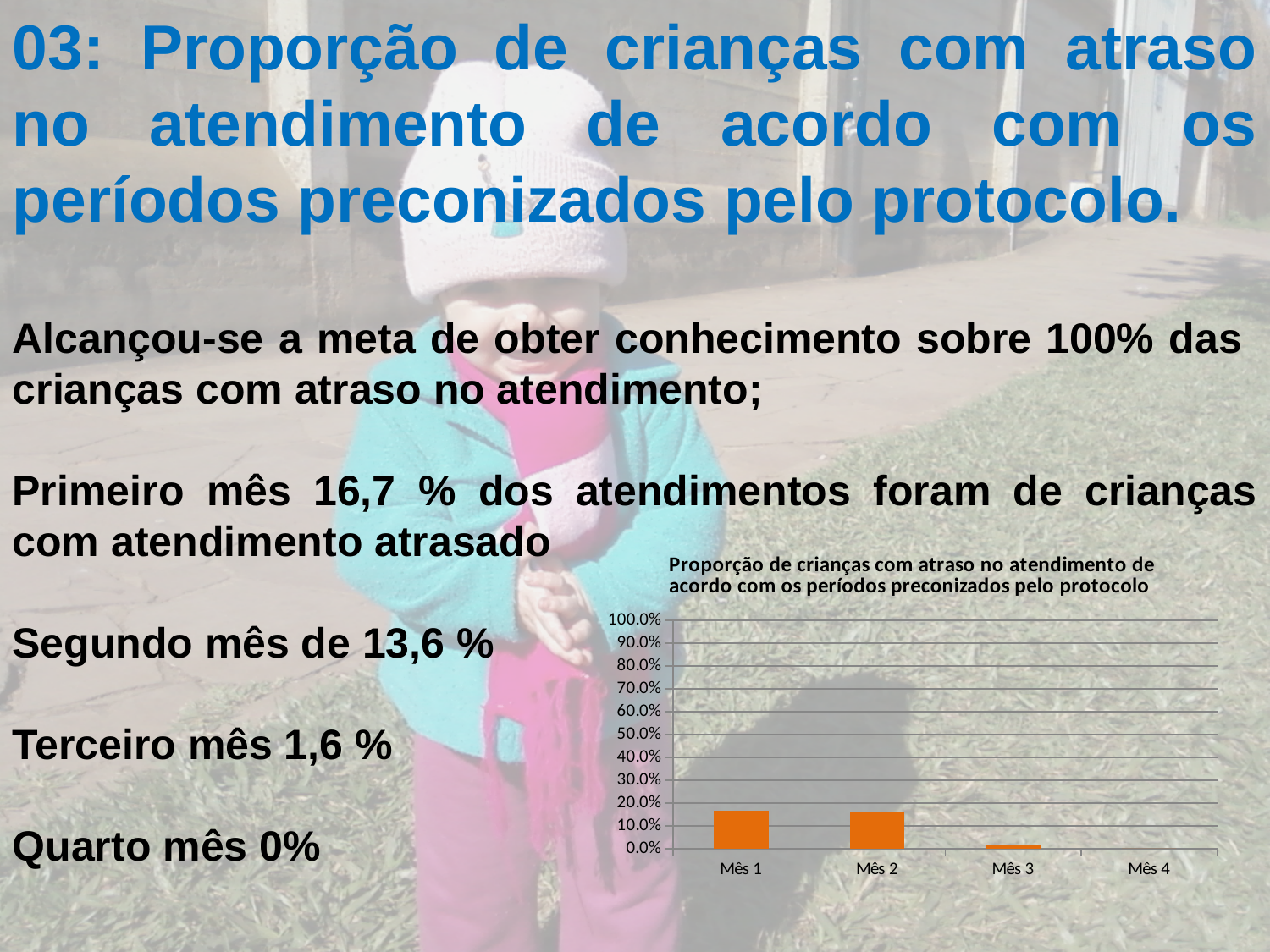
Is the value for Mês 3 greater or less than 10.0%? less Which category has the lowest value in the chart? Mês 4 Which is larger, the value for Mês 2 or the value for Mês 3? Mês 2 Do the values rise or fall from Mês 1 to Mês 4? fall Is the value for Mês 1 greater or less than 10.0%? greater What kind of chart is shown on the slide? bar chart Is the value for Mês 2 greater or less than 10.0%? greater Which is larger, the value for Mês 1 or the value for Mês 3? Mês 1 Which category has the highest bar in the chart? Mês 1 What is the title of the chart? Proporção de crianças com atraso no atendimento de acordo com os períodos preconizados pelo protocolo How many categories are shown on the x axis of the chart? 4